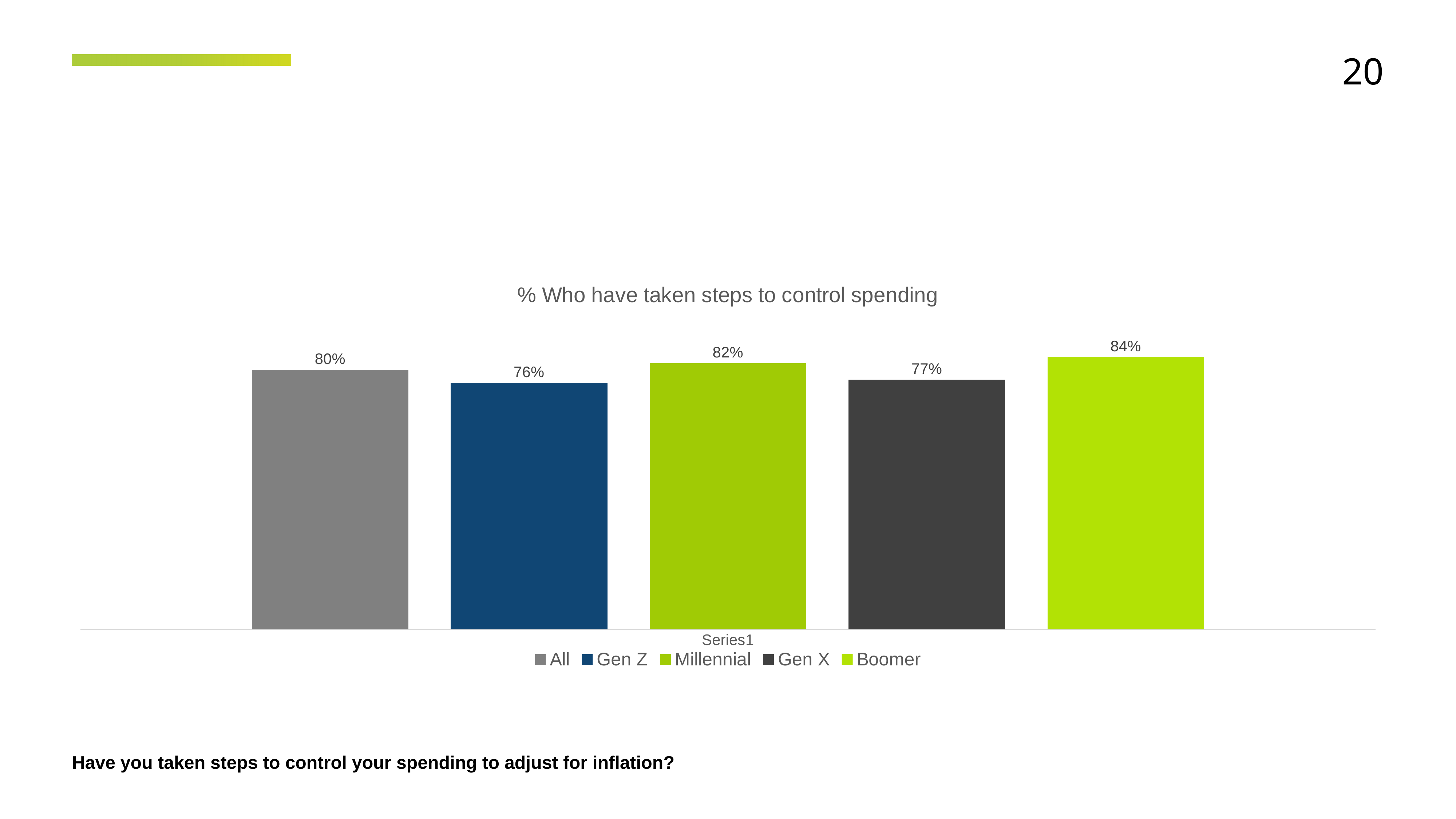
Which group has the highest value in the chart? Boomer What is the value for Millennial in the chart? 82% What kind of chart is shown on the slide? Bar chart What is the value for Gen Z in the chart? 76% What is the difference between the Millennial value and the Gen X value? 5% What is the difference between the Boomer value and the Gen Z value? 8% What is the title of the chart? % Who have taken steps to control spending Which is larger, the value for Millennial or the value for Gen X? Millennial What is the value for All in the chart? 80% How many series does the legend list? 5 What is the value for Boomer in the chart? 84% Which group has the lowest value in the chart? Gen Z